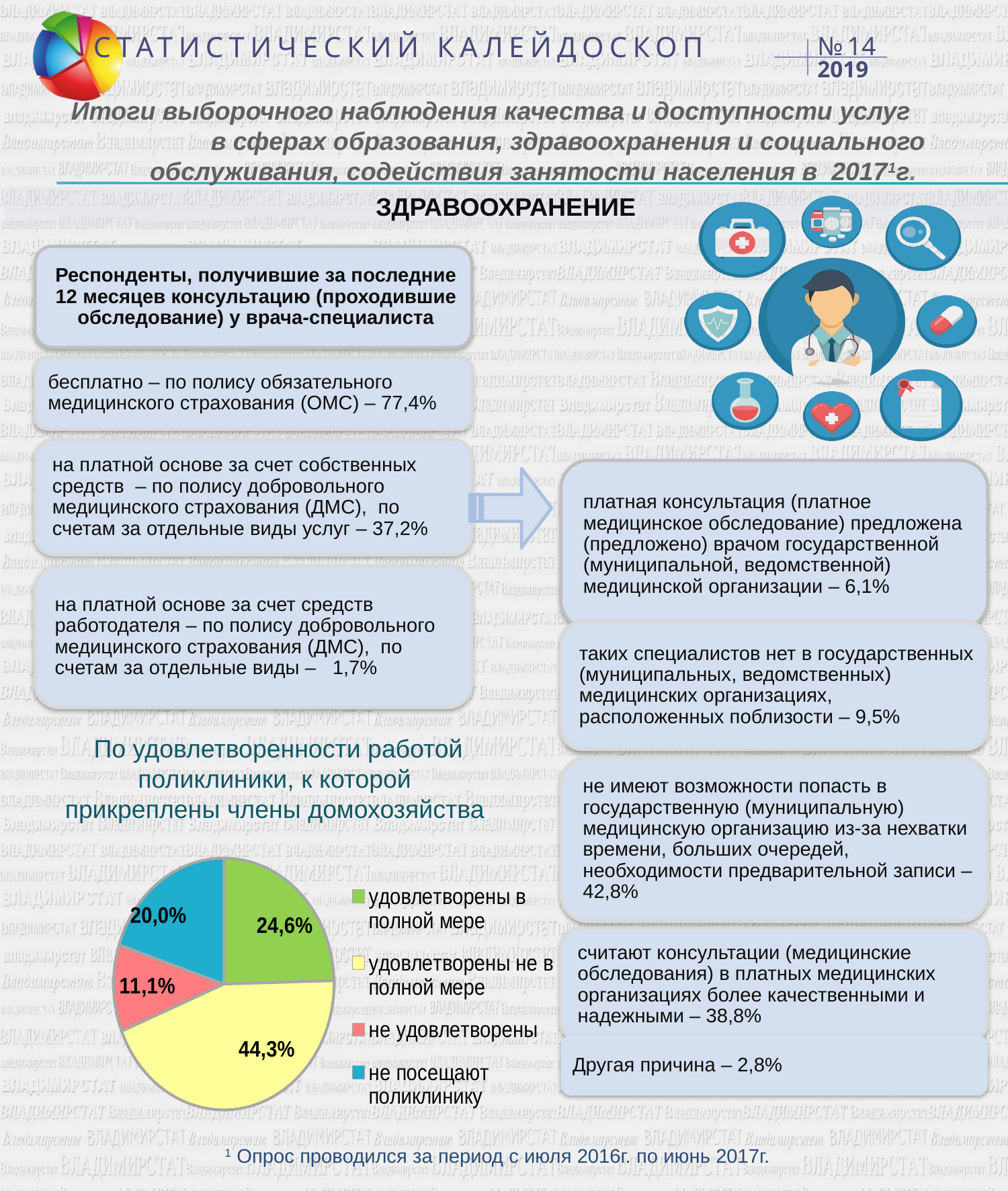
What share of respondents are 'не удовлетворены' in the pie chart? 11,1% What colour is the slice for 'не удовлетворены' in the pie chart? red How many slices does the pie chart have? 4 Which is larger: the share for 'не посещают поликлинику' or the share for 'не удовлетворены'? не посещают поликлинику Which category has the smallest slice in the pie chart? не удовлетворены What share of respondents are 'удовлетворены не в полной мере' in the pie chart? 44,3% What share of respondents 'не посещают поликлинику' according to the pie chart? 20,0% What share of respondents are 'удовлетворены в полной мере' in the pie chart? 24,6% What is the difference between the shares for 'удовлетворены не в полной мере' and 'удовлетворены в полной мере'? 19,7% Which category has the largest slice in the pie chart? удовлетворены не в полной мере What is the difference between the shares for 'не посещают поликлинику' and 'не удовлетворены'? 8,9% What type of chart is shown on the slide? pie chart